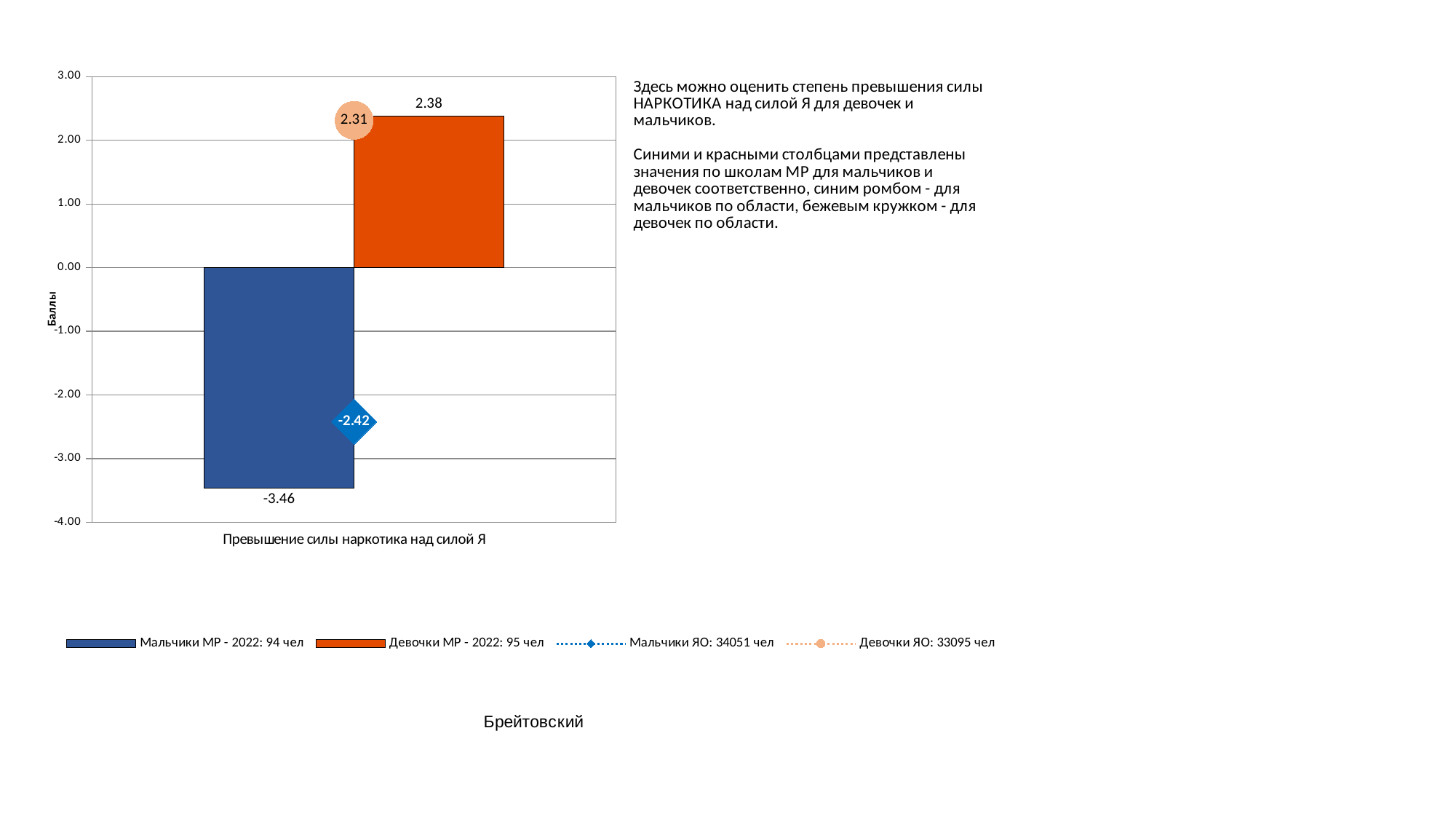
Which series has the lowest value? Мальчики МР - 2022: 94 чел Is the value for Мальчики МР - 2022: 94 чел greater or less than -3.00? less What is the value for Девочки МР - 2022: 95 чел? 2.38 Which is larger, the value for Мальчики МР - 2022: 94 чел or the value for Мальчики ЯО: 34051 чел? Мальчики ЯО: 34051 чел Which series has the highest value? Девочки МР - 2022: 95 чел What is the difference between the values for Девочки МР - 2022: 95 чел and Девочки ЯО: 33095 чел? 0.07 What is the value for Мальчики ЯО: 34051 чел? -2.42 What is the value for Мальчики МР - 2022: 94 чел? -3.46 What is the value for Девочки ЯО: 33095 чел? 2.31 What is the label of the vertical axis? Баллы What kind of chart is shown on the slide? bar chart How many series does the legend list? 4